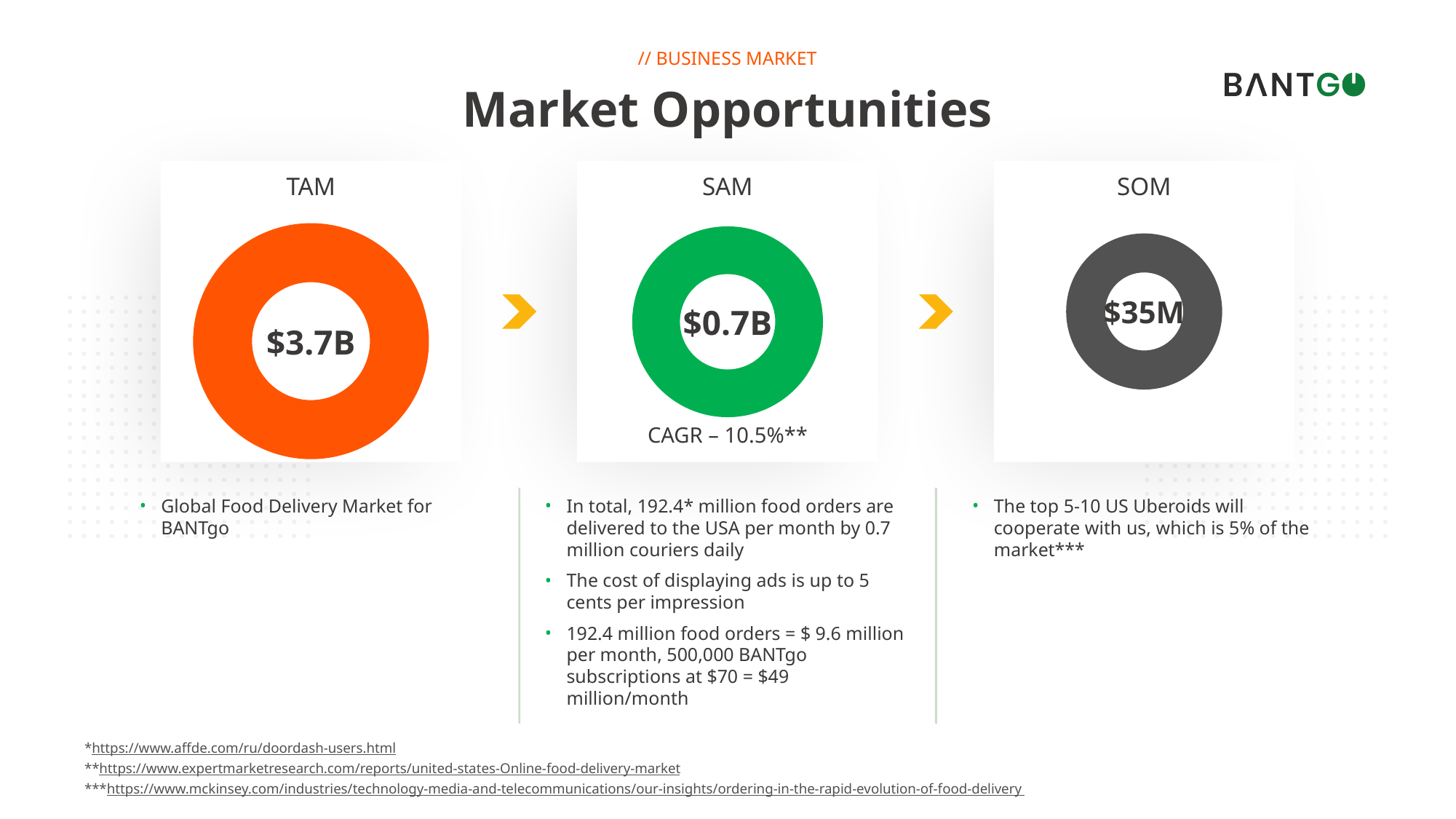
What colour is the SAM donut chart? Green Which is larger, the SAM value or the SOM value? SAM What value is shown in the centre of the SAM chart? $0.7B Which of the three charts (TAM, SAM, SOM) shows the smallest value? SOM How many donut charts are shown on the slide? 3 What value is shown in the centre of the TAM chart? $3.7B What is the difference between the TAM value and the SAM value? $3.0B What CAGR is printed beneath the SAM chart? 10.5% Which of the three charts (TAM, SAM, SOM) shows the largest value? TAM What colour is the TAM donut chart? Orange What kind of chart is used to display the TAM, SAM and SOM values? Donut chart What value is shown in the centre of the SOM chart? $35M